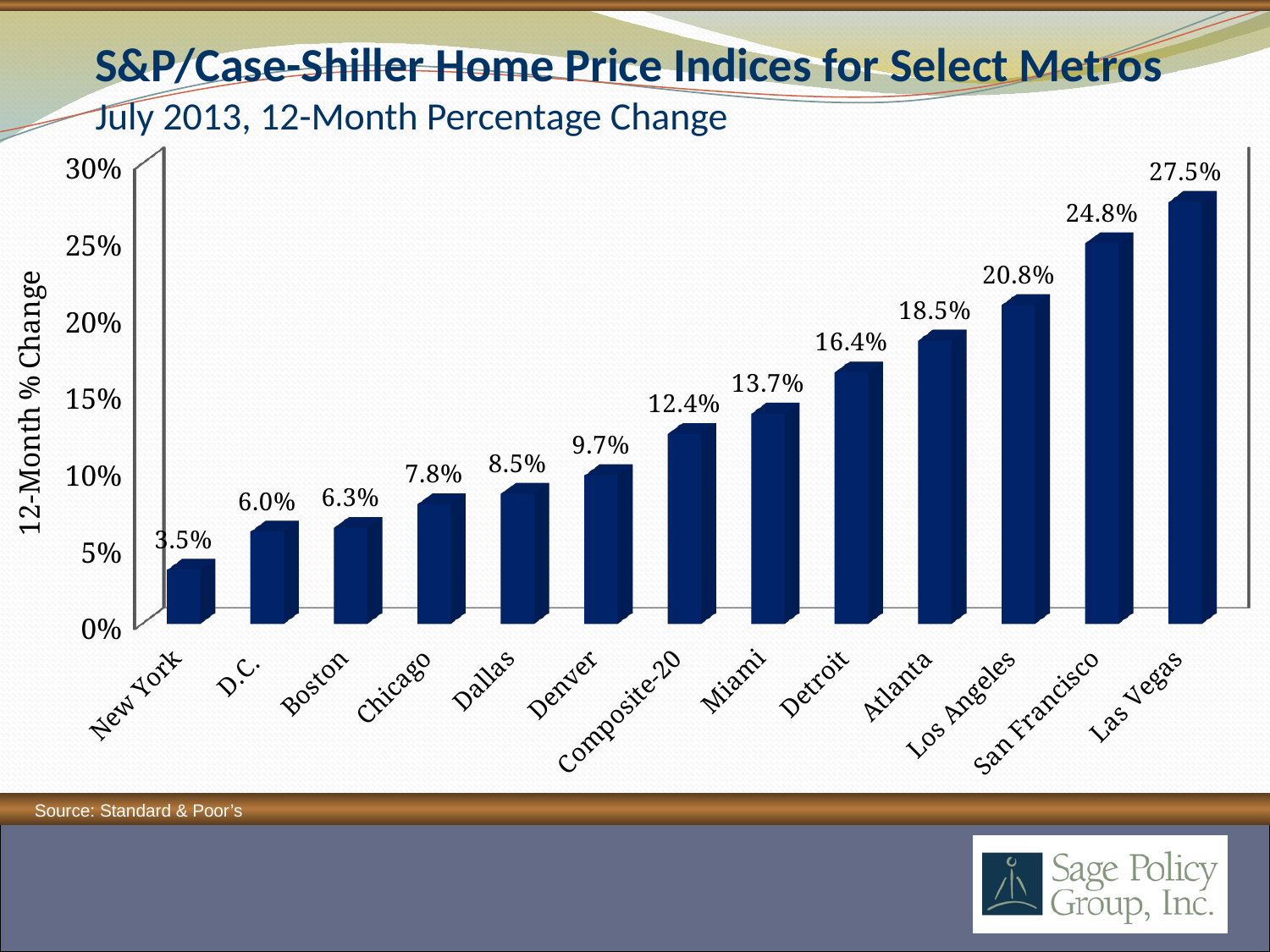
Is the value for Chicago greater or less than 10%? less Which has a larger 12-month percentage change, Atlanta or Denver? Atlanta How many metros (categories) are shown on the chart? 13 What kind of chart is shown on the slide? Bar chart What is the difference between the values for San Francisco and Los Angeles? 4.0% What is the 12-month percentage change for Las Vegas? 27.5% Do the values rise or fall moving from left to right along the x axis? Rise What is the 12-month percentage change for Composite-20? 12.4% What is the difference between the values for Miami and New York? 10.2% Which metro has the lowest 12-month percentage change? New York Which metro has the highest 12-month percentage change? Las Vegas What is the 12-month percentage change for Detroit? 16.4%